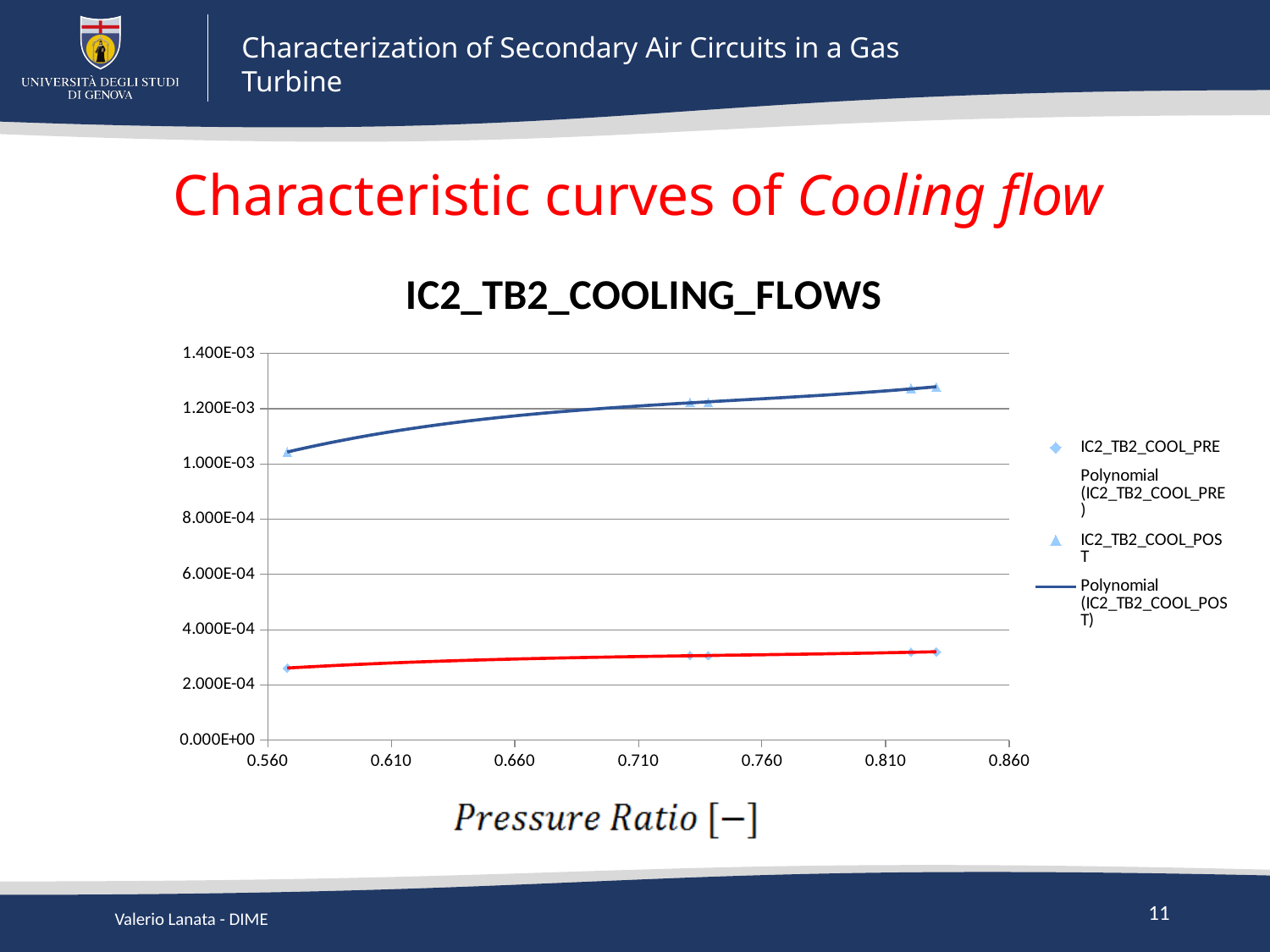
What is the label of the x axis? Pressure Ratio [-] Which series has the higher values, IC2_TB2_COOL_PRE or IC2_TB2_COOL_POST? IC2_TB2_COOL_POST Is the IC2_TB2_COOL_PRE value at the lowest pressure ratio greater or less than 2.000E-04? greater Is the IC2_TB2_COOL_POST value at the highest pressure ratio greater or less than 1.200E-03? greater What is the title of the chart? IC2_TB2_COOLING_FLOWS Is the IC2_TB2_COOL_PRE value at the highest pressure ratio greater or less than 4.000E-04? less How many entries does the chart legend list? 4 Do the IC2_TB2_COOL_PRE values rise or fall as the pressure ratio increases? rise Do the IC2_TB2_COOL_POST values rise or fall as the pressure ratio increases? rise What is the highest value shown on the y axis? 1.400E-03 What kind of chart is shown on the slide? scatter chart with polynomial trendlines